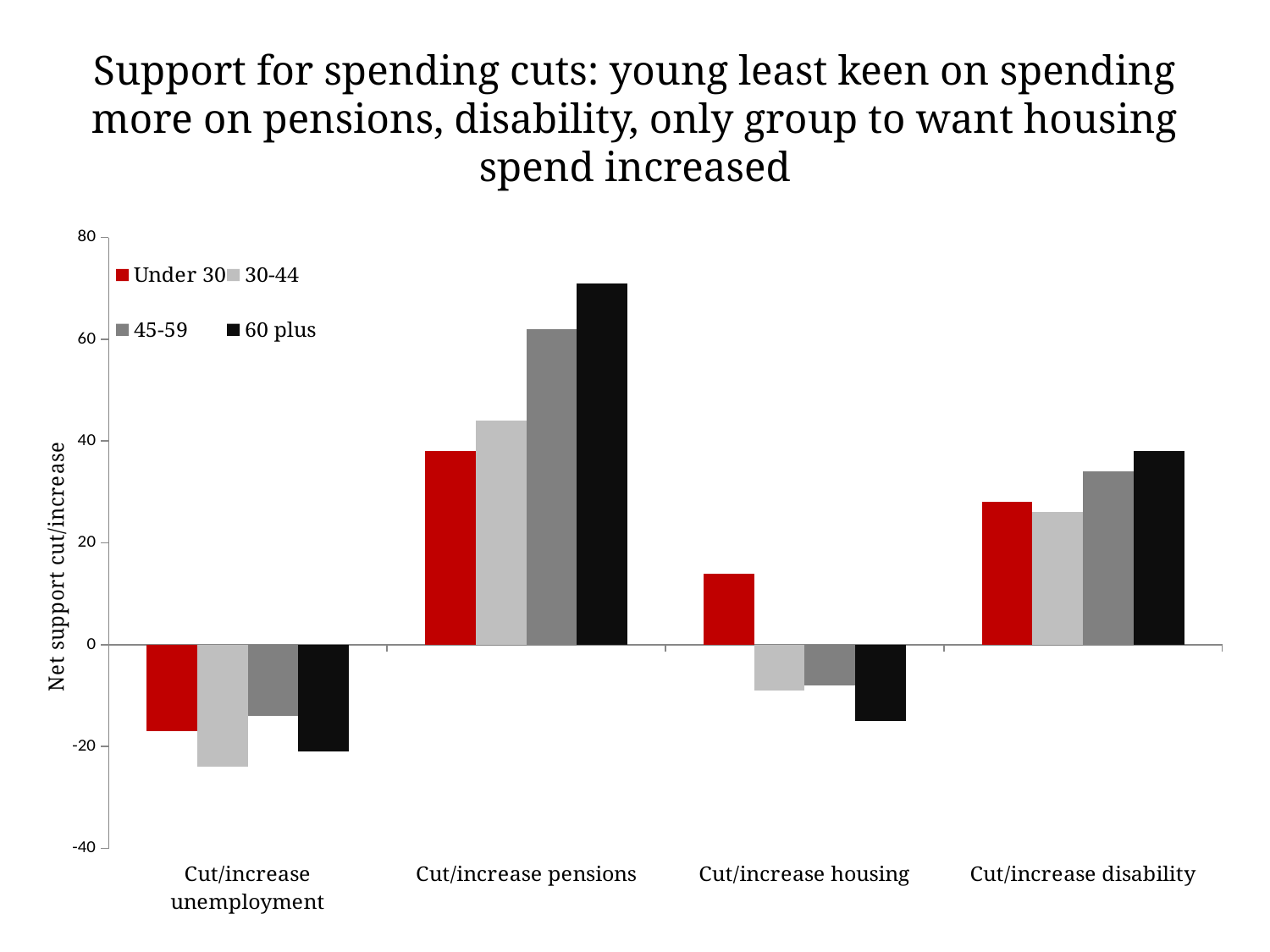
For Cut/increase disability, which is larger: the value for 60 plus or the value for Under 30? 60 plus What kind of chart is shown on the slide? Bar chart Which age group has the lowest value for Cut/increase unemployment? 30-44 Which age group is the only one with a positive value for Cut/increase housing? Under 30 How many series does the legend list? 4 How many categories are shown on the x axis? 4 Is the value for 30-44 in Cut/increase unemployment greater or less than -20? less What is the title of the vertical axis? Net support cut/increase Which age group has the highest value for Cut/increase pensions? 60 plus Is the value for 60 plus in Cut/increase pensions greater or less than 60? greater For Cut/increase pensions, which is larger: the value for 45-59 or the value for 30-44? 45-59 Is the value for Under 30 in Cut/increase housing greater or less than 0? greater